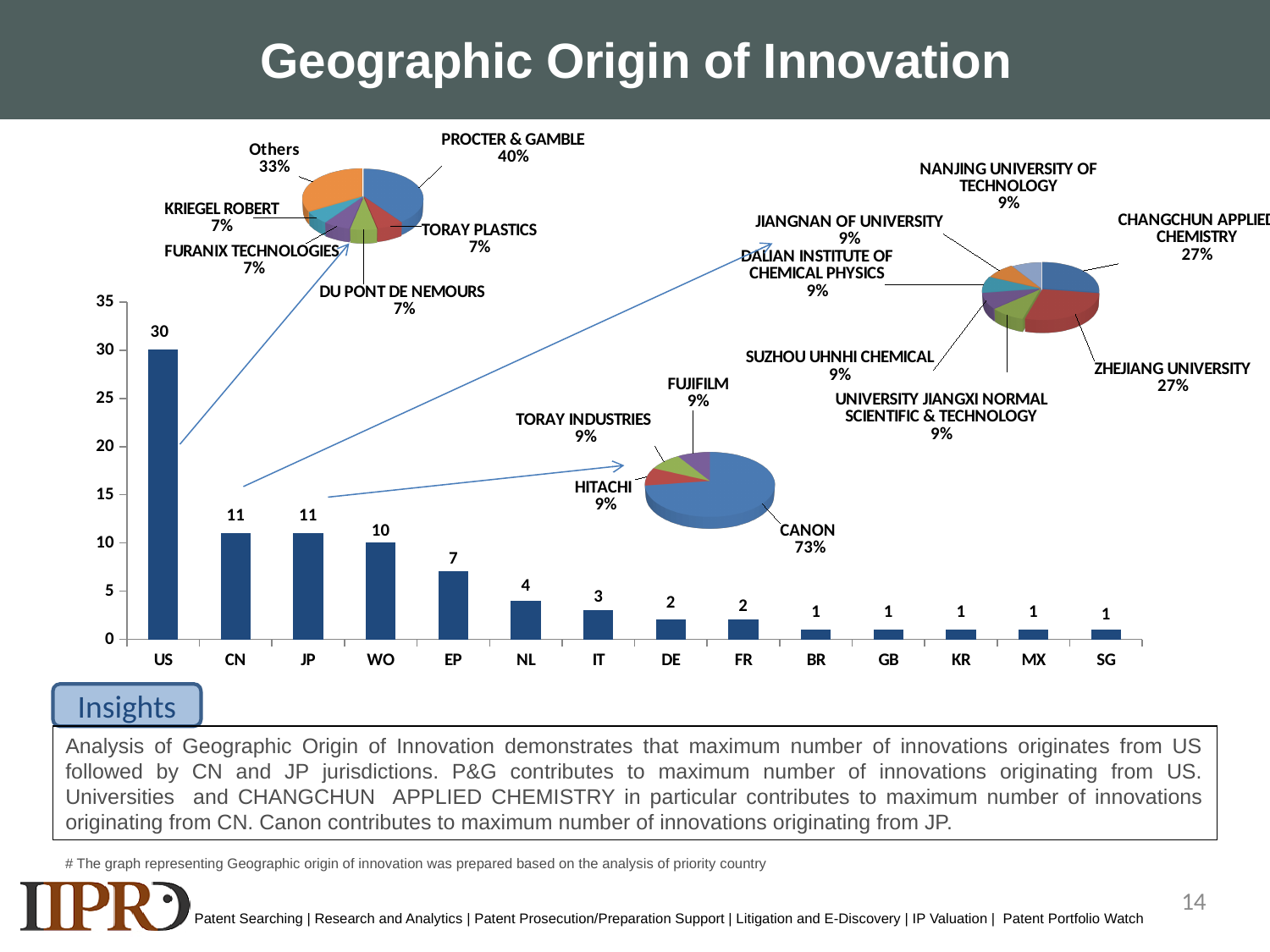
How many categories are shown on the x axis of the bar chart? 14 In the bar chart, what is the value for US? 30 In the bar chart, what is the value for WO? 10 In the pie chart in the middle of the slide, what share does Canon have? 73% In the bar chart, do the values generally rise or fall from left to right along the x axis? Fall In the pie chart at the top left, what share does Procter & Gamble have? 40% In the bar chart, which category has the highest value? US In the bar chart, what is the difference between the values for US and CN? 19 In the pie chart at the top left, what share does Others have? 33% In the bar chart, which is larger, the value for EP or the value for NL? EP What kind of chart is the chart with the country codes US, CN, JP on the x axis? Bar chart